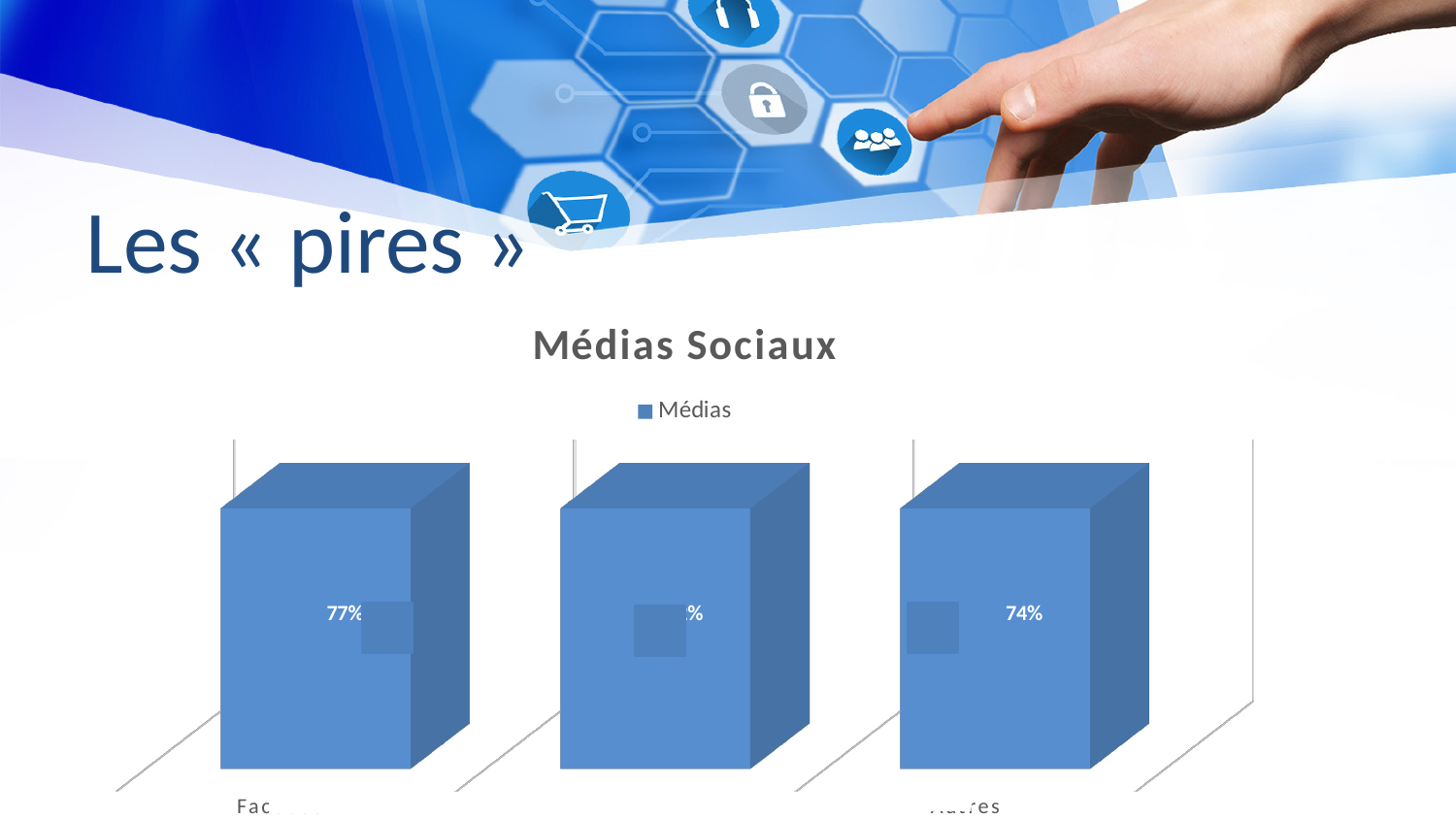
What kind of chart is shown on the slide? bar chart Which is larger, the value of the leftmost bar or the rightmost bar? the leftmost bar What is the difference between the leftmost bar's value and the rightmost bar's value? 3% What is the title of the chart? Médias Sociaux How many bars are plotted in the chart? 3 What value is printed on the leftmost bar of the chart? 77% What series name does the chart legend list? Médias What value is printed on the rightmost bar of the chart? 74% How many series does the legend list? 1